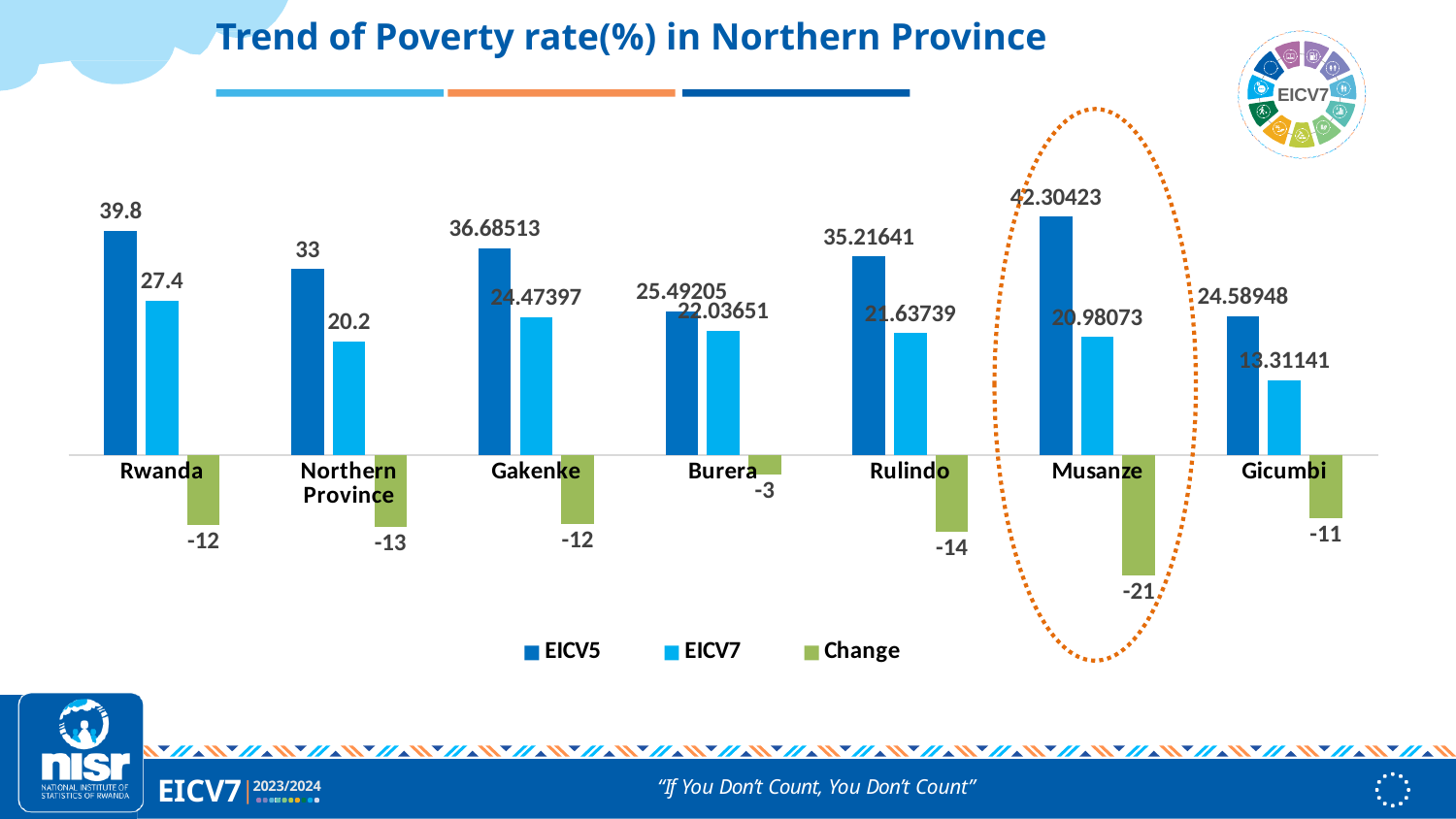
Which category has the largest negative Change value? Musanze What kind of chart is shown on the slide? Bar chart How many categories are shown on the x axis? 7 What is the difference between the EICV5 and EICV7 poverty rates for Rwanda? 12.4 How many series does the legend list? 3 What is the Change value for Burera? -3 What is the EICV5 poverty rate for Musanze? 42.30423 Which category has the lowest EICV7 poverty rate? Gicumbi What is the EICV7 poverty rate for Gicumbi? 13.31141 Which is larger, the EICV5 poverty rate for Gakenke or for Rulindo? Gakenke Which category has the highest EICV5 poverty rate? Musanze What is the EICV7 poverty rate for Northern Province? 20.2